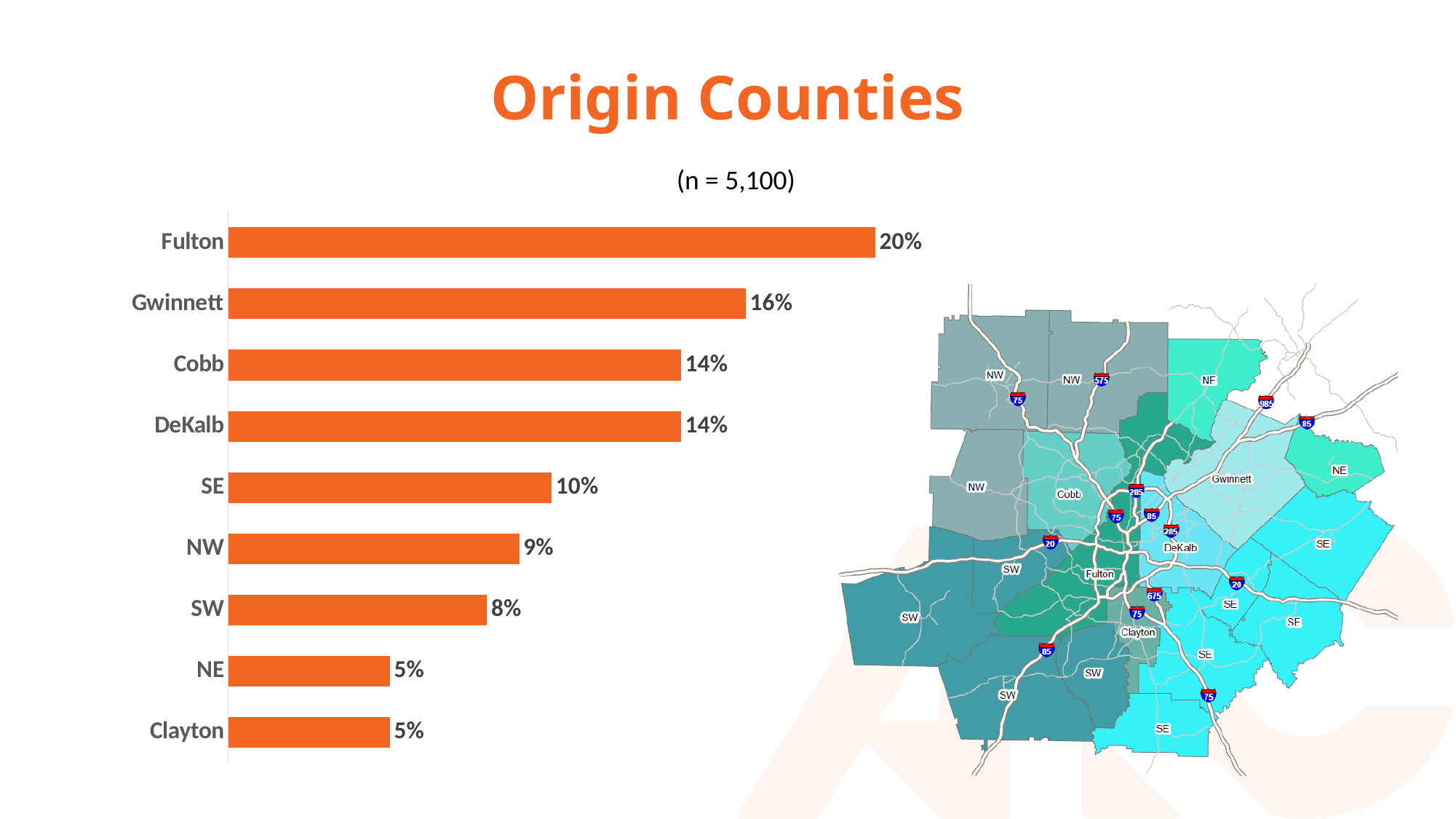
Which county has the highest share of origins? Fulton What is the difference between the values for NW and SW? 1% What is the title of the slide? Origin Counties What percentage of origins are from Fulton county? 20% Which has a larger value, Gwinnett or Cobb? Gwinnett What percentage is shown for SE? 10% What is the value shown for Gwinnett? 16% What is the sample size (n) stated on the slide? 5,100 What is the difference between the values for Fulton and Gwinnett? 4% How many categories are shown on the bar chart? 9 What kind of chart is used to show the origin counties? Bar chart Which categories share the lowest value on the chart? NE and Clayton